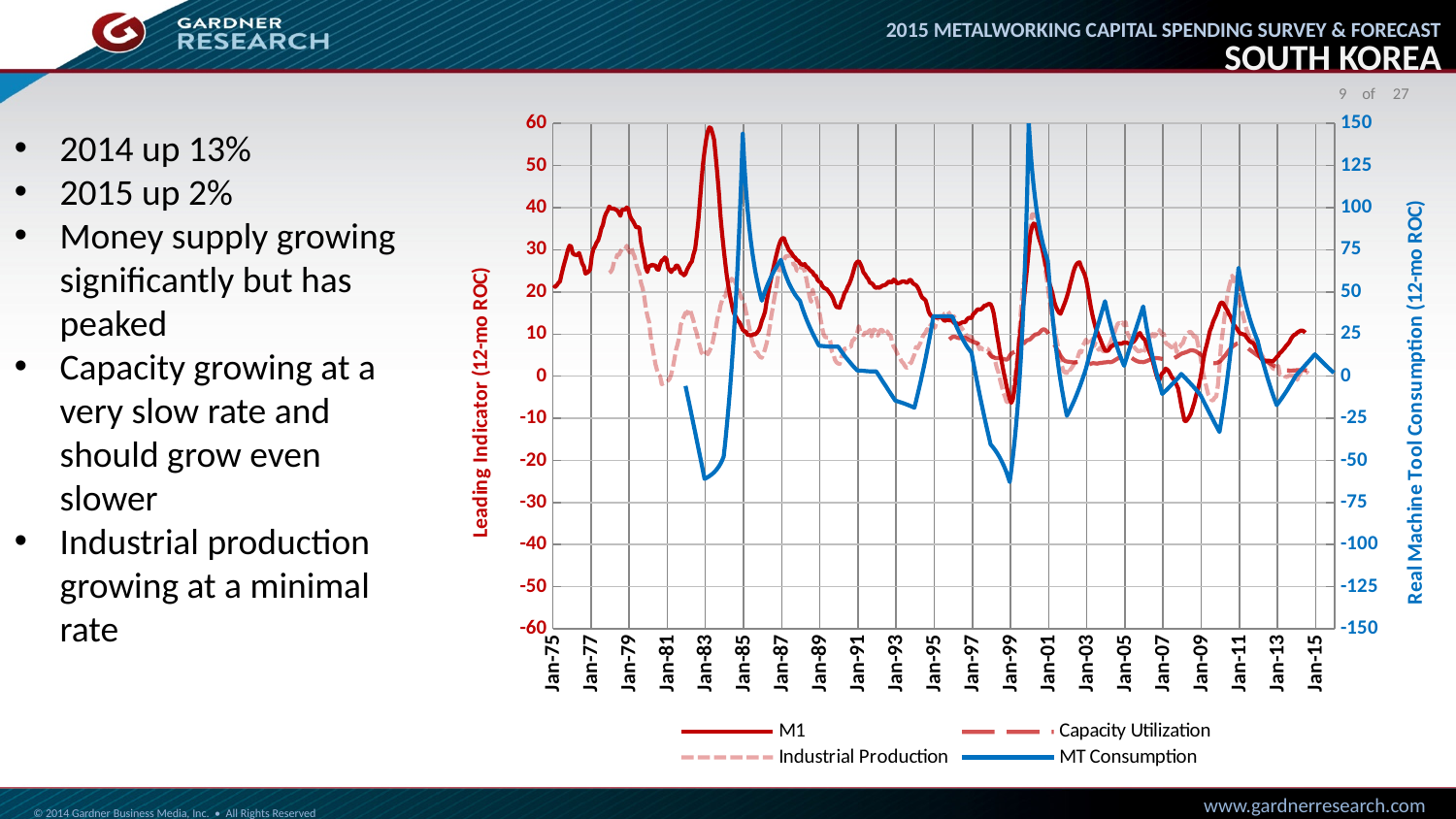
Which is higher: the M1 value around Jan-83 or the M1 value around Jan-99? Jan-83 What kind of chart is shown on the slide? line chart Is the peak value of M1 around Jan-83 greater or less than 50 on the left axis? greater Is the value of MT Consumption around Jan-83 greater or less than -50 on the right axis? less Is the value of M1 at Jan-75 greater or less than 10 on the left axis? greater Which series in the legend is drawn as a solid blue line? MT Consumption How many series does the chart legend list? 4 Does the M1 line rise or fall between its peak around Jan-83 and Jan-85? fall How many year labels are shown along the x axis? 21 What is the title of the right-hand vertical axis? Real Machine Tool Consumption (12-mo ROC)